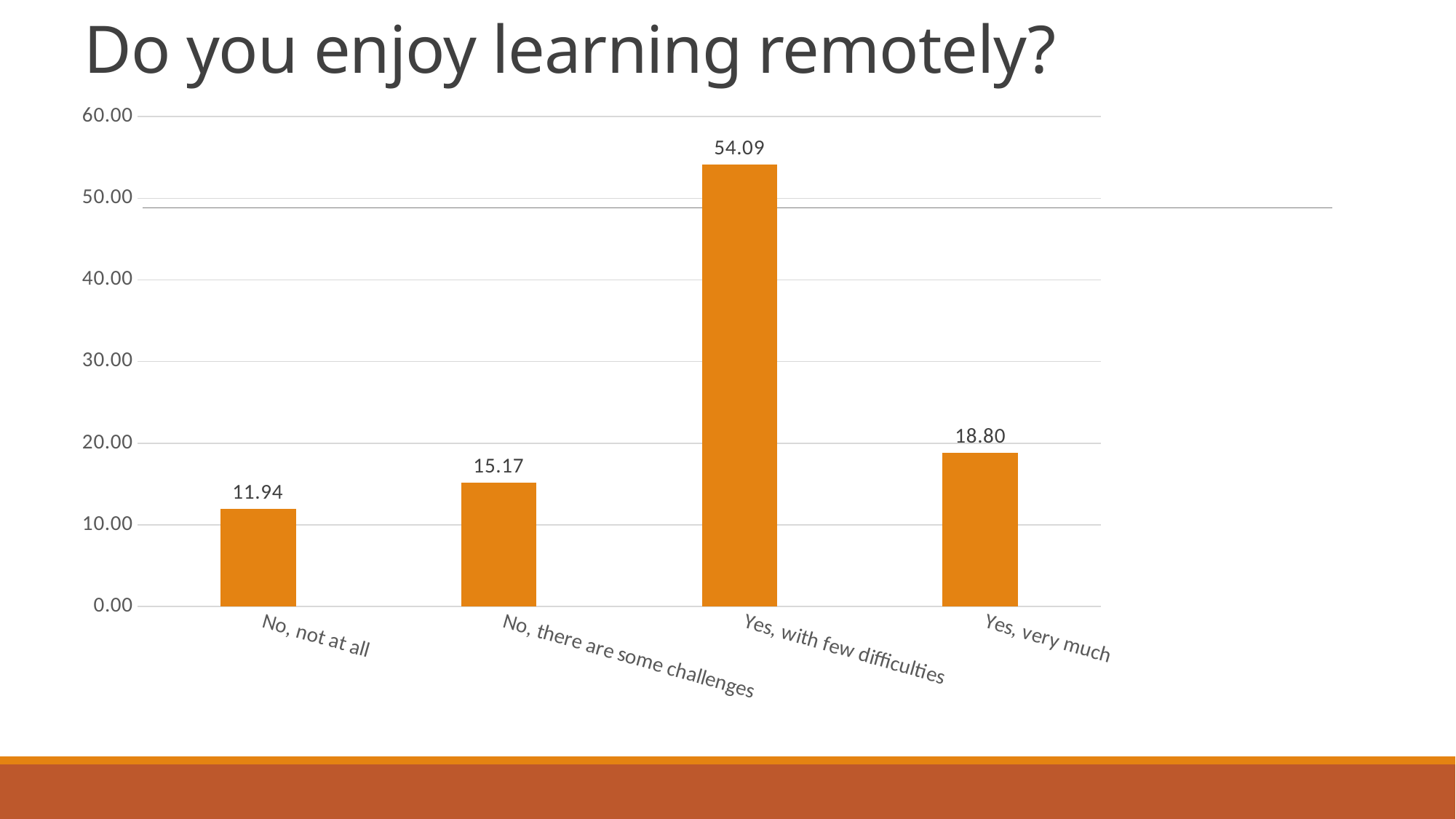
What is the difference between the values for "No, there are some challenges" and "No, not at all"? 3.23 What is the value for "No, not at all"? 11.94 Which category has the highest value? Yes, with few difficulties Which is larger: the value for "Yes, very much" or the value for "No, there are some challenges"? Yes, very much What is the difference between the values for "Yes, with few difficulties" and "Yes, very much"? 35.29 What kind of chart is shown on the slide? bar chart What is the value for "No, there are some challenges"? 15.17 What is the value for "Yes, very much"? 18.80 What is the value for "Yes, with few difficulties"? 54.09 How many categories are shown on the chart? 4 Which category has the lowest value? No, not at all Is the value for "Yes, with few difficulties" greater or less than 50.00? greater